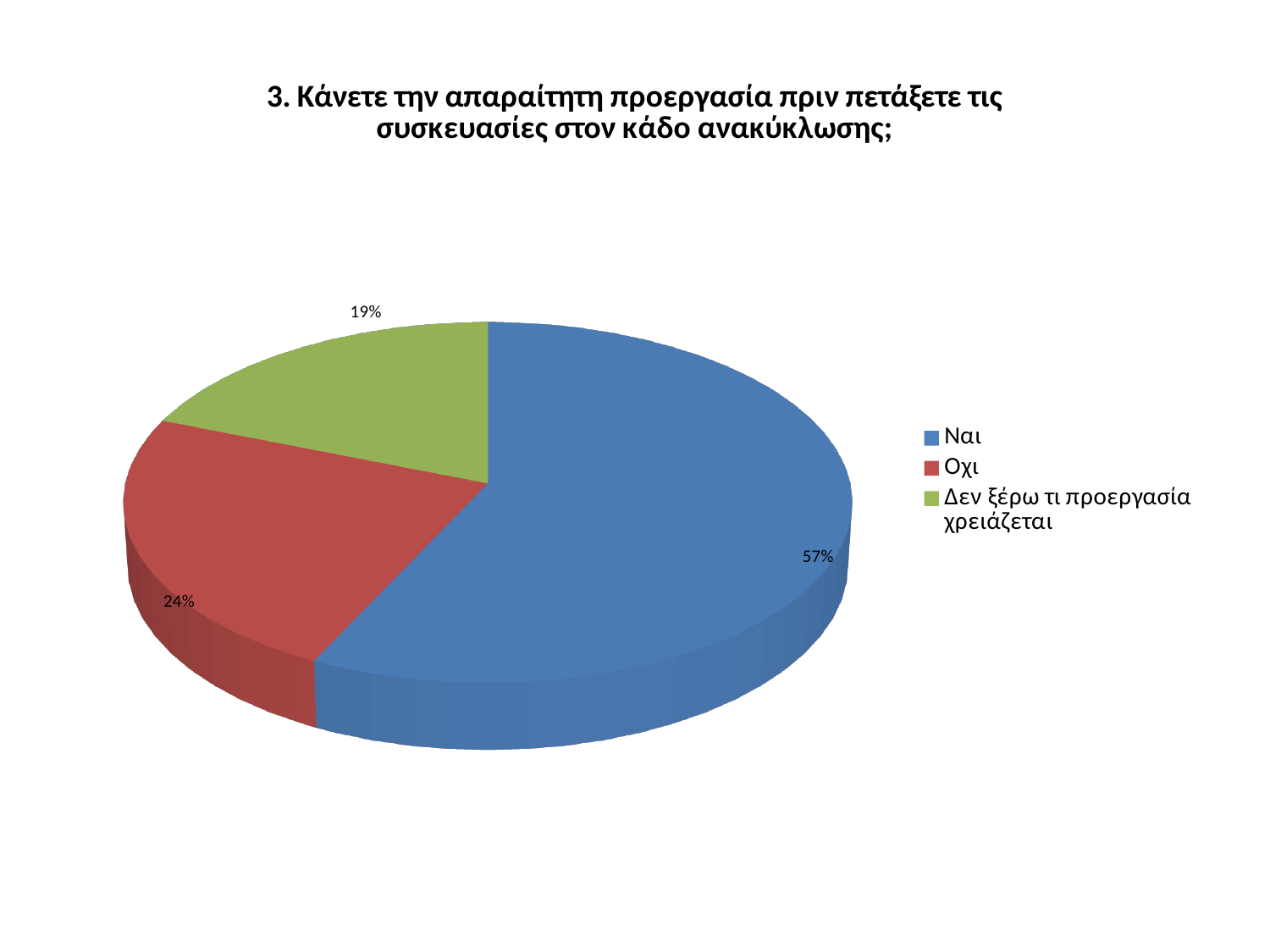
What is the difference in percentage points between the 'Ναι' and 'Οχι' slices? 33 Which category has the smallest share of the pie? Δεν ξέρω τι προεργασία χρειάζεται Which category has the largest share of the pie? Ναι What colour is the 'Οχι' slice? red What percentage of the pie is the 'Οχι' slice? 24% Which is larger, the 'Οχι' slice or the 'Δεν ξέρω τι προεργασία χρειάζεται' slice? Οχι What percentage of the pie is the 'Δεν ξέρω τι προεργασία χρειάζεται' slice? 19% What kind of chart is shown on the slide? pie chart What colour is the 'Ναι' slice? blue How many slices does the pie chart have? 3 What percentage of the pie is the 'Ναι' slice? 57% What is the difference in percentage points between the 'Οχι' and 'Δεν ξέρω τι προεργασία χρειάζεται' slices? 5